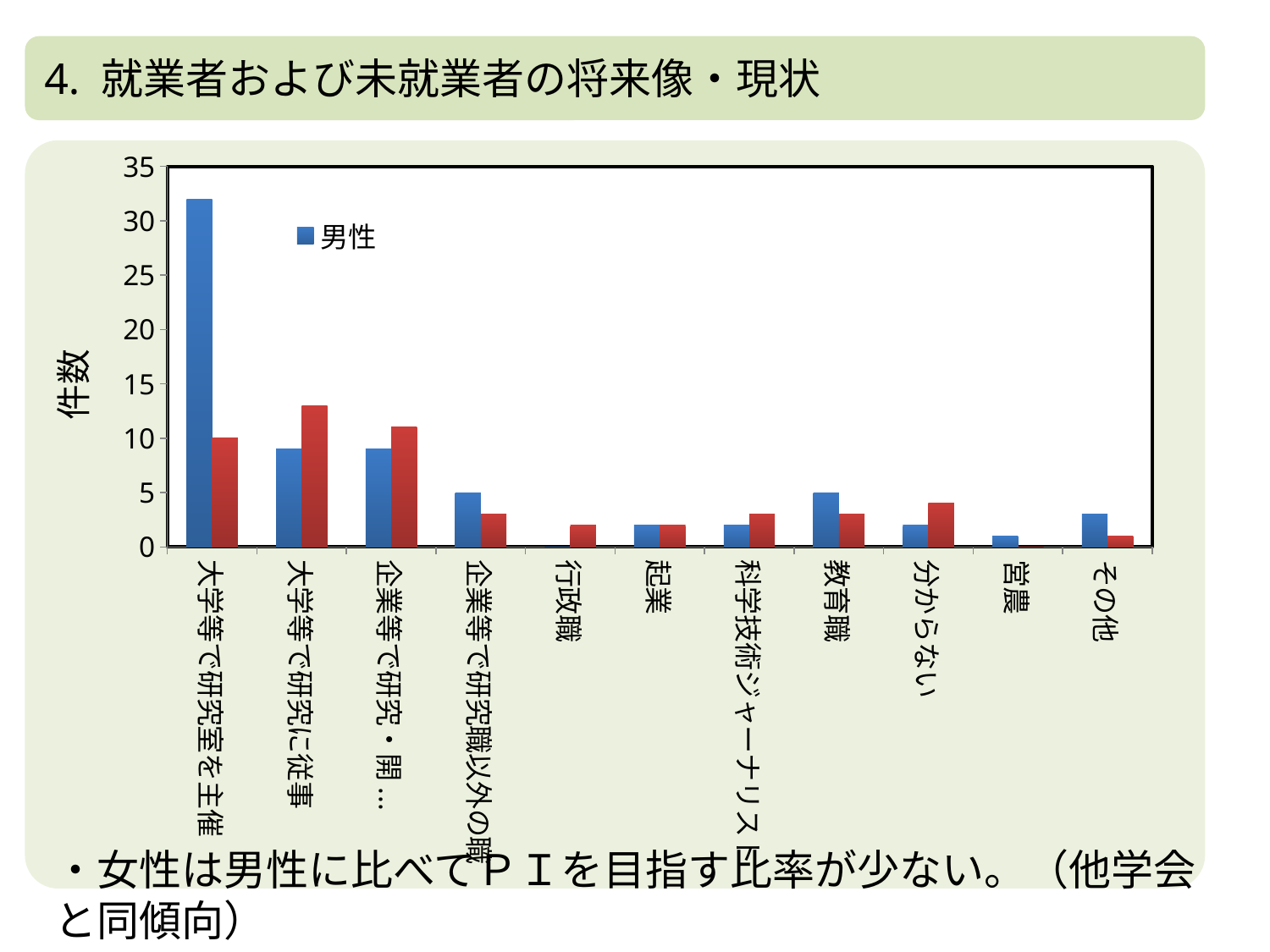
What is the 男性 value for 教育職? 5 What is the value of the red bar for 大学等で研究室を主催? 10 Is the 男性 value for 大学等で研究室を主催 greater or less than 30? greater Which category has the highest value for the 男性 series? 大学等で研究室を主催 How many categories are shown on the x axis of the chart? 11 For 大学等で研究に従事, which bar is larger, the blue (男性) bar or the red bar? the red bar How many series does the chart's legend list? 1 Which is larger for the 男性 series: 大学等で研究室を主催 or 大学等で研究に従事? 大学等で研究室を主催 What is the label on the y axis of the chart? 件数 What kind of chart is shown on the slide? bar chart What is the 男性 value for 企業等で研究職以外の職? 5 Is the value of the red bar for 大学等で研究に従事 greater or less than 10? greater